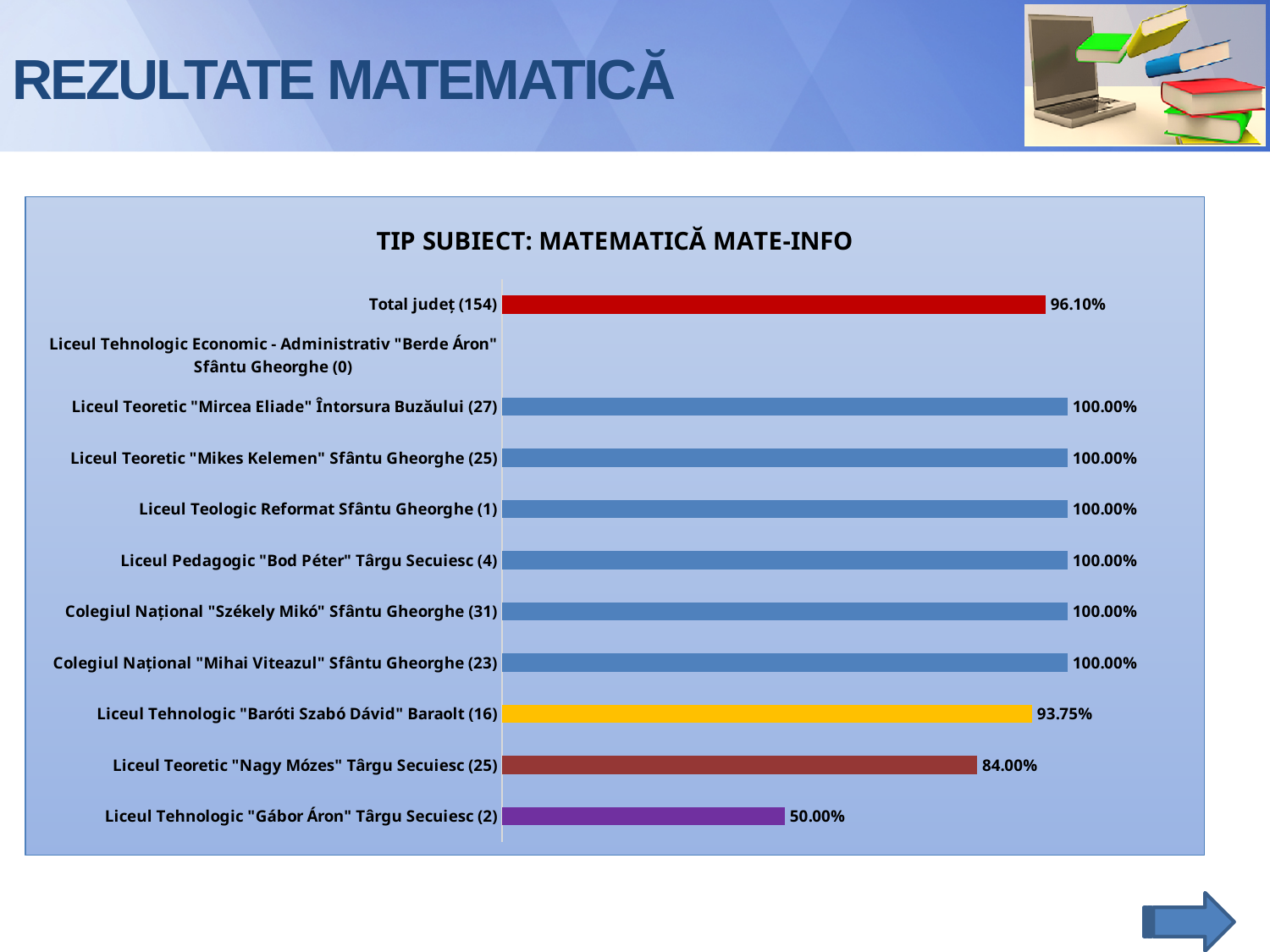
What is the difference between the value for Total județ (154) and the value for Liceul Teoretic "Nagy Mózes" Târgu Secuiesc (25)? 12.10% How many categories are listed on the chart's vertical axis? 11 Which is larger: the value for Total județ (154) or the value for Liceul Tehnologic "Baróti Szabó Dávid" Baraolt (16)? Total județ (154) What is the value for Liceul Tehnologic "Baróti Szabó Dávid" Baraolt (16)? 93.75% What is the value for Liceul Teoretic "Nagy Mózes" Târgu Secuiesc (25)? 84.00% What kind of chart is shown on the slide? Bar chart What is the title of the chart? TIP SUBIECT: MATEMATICĂ MATE-INFO What is the value for Liceul Tehnologic "Gábor Áron" Târgu Secuiesc (2)? 50.00% What is the value for Colegiul Național "Székely Mikó" Sfântu Gheorghe (31)? 100.00% What is the difference between the value for Liceul Tehnologic "Baróti Szabó Dávid" Baraolt (16) and the value for Liceul Tehnologic "Gábor Áron" Târgu Secuiesc (2)? 43.75% Which category with a plotted bar has the lowest value? Liceul Tehnologic "Gábor Áron" Târgu Secuiesc (2) What is the value for Total județ (154)? 96.10%